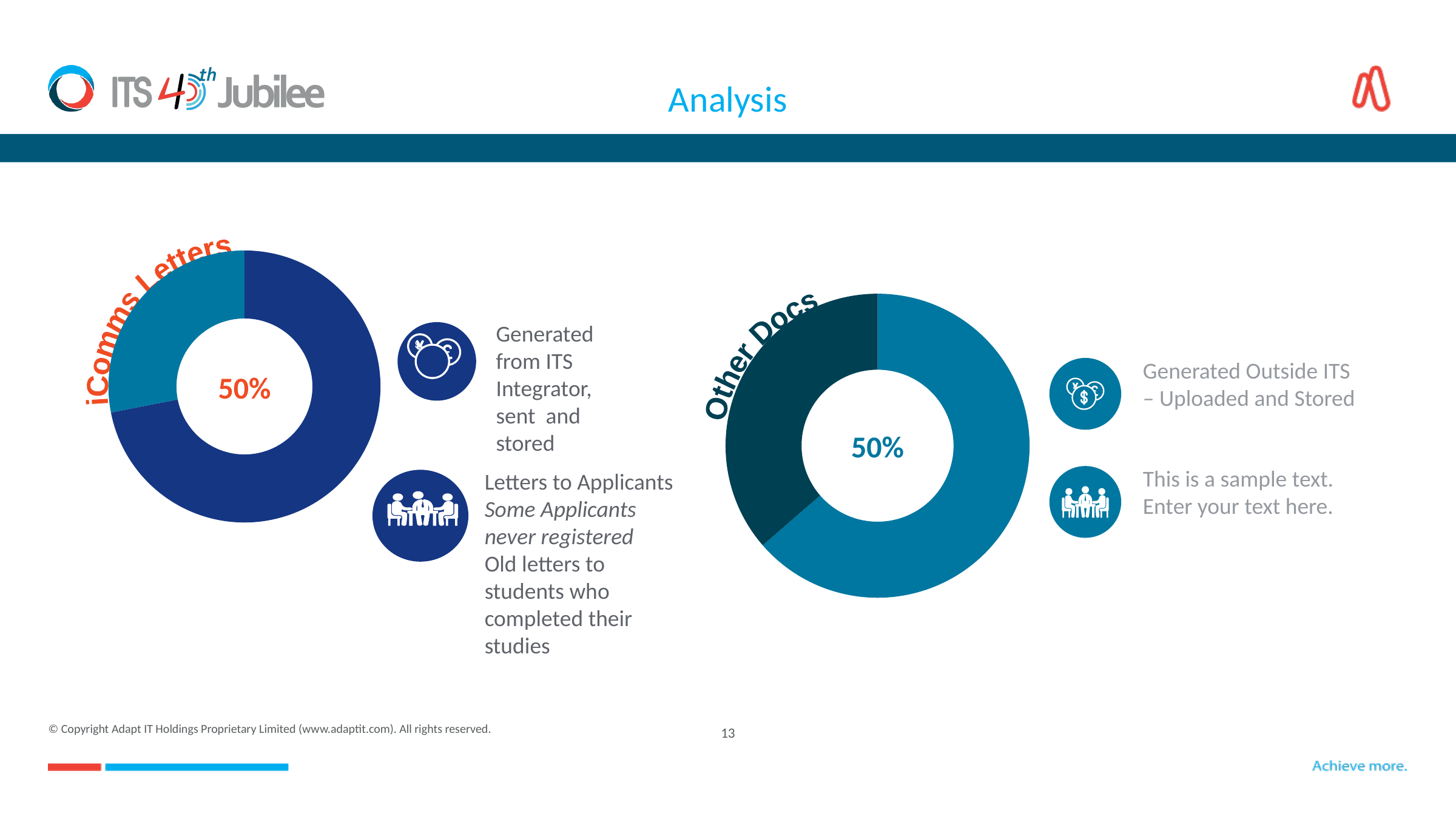
What percentage is printed in the centre of the Other Docs chart? 50% What kind of chart is the chart labelled Other Docs? pie chart (donut) In the iComms Letters chart, which slice is larger, the dark blue one or the teal one? dark blue How many slices does the Other Docs chart have? 2 What percentage is printed in the centre of the iComms Letters chart? 50% In the Other Docs chart, which slice is larger, the light teal one or the dark teal one? light teal How many slices does the iComms Letters chart have? 2 In the iComms Letters chart, is the dark blue slice's share greater or less than 50%? greater What is the label written along the right-hand chart? Other Docs What is the label written along the left-hand chart? iComms Letters What kind of chart is the chart labelled iComms Letters? pie chart (donut) In the Other Docs chart, is the dark teal slice's share greater or less than 50%? less